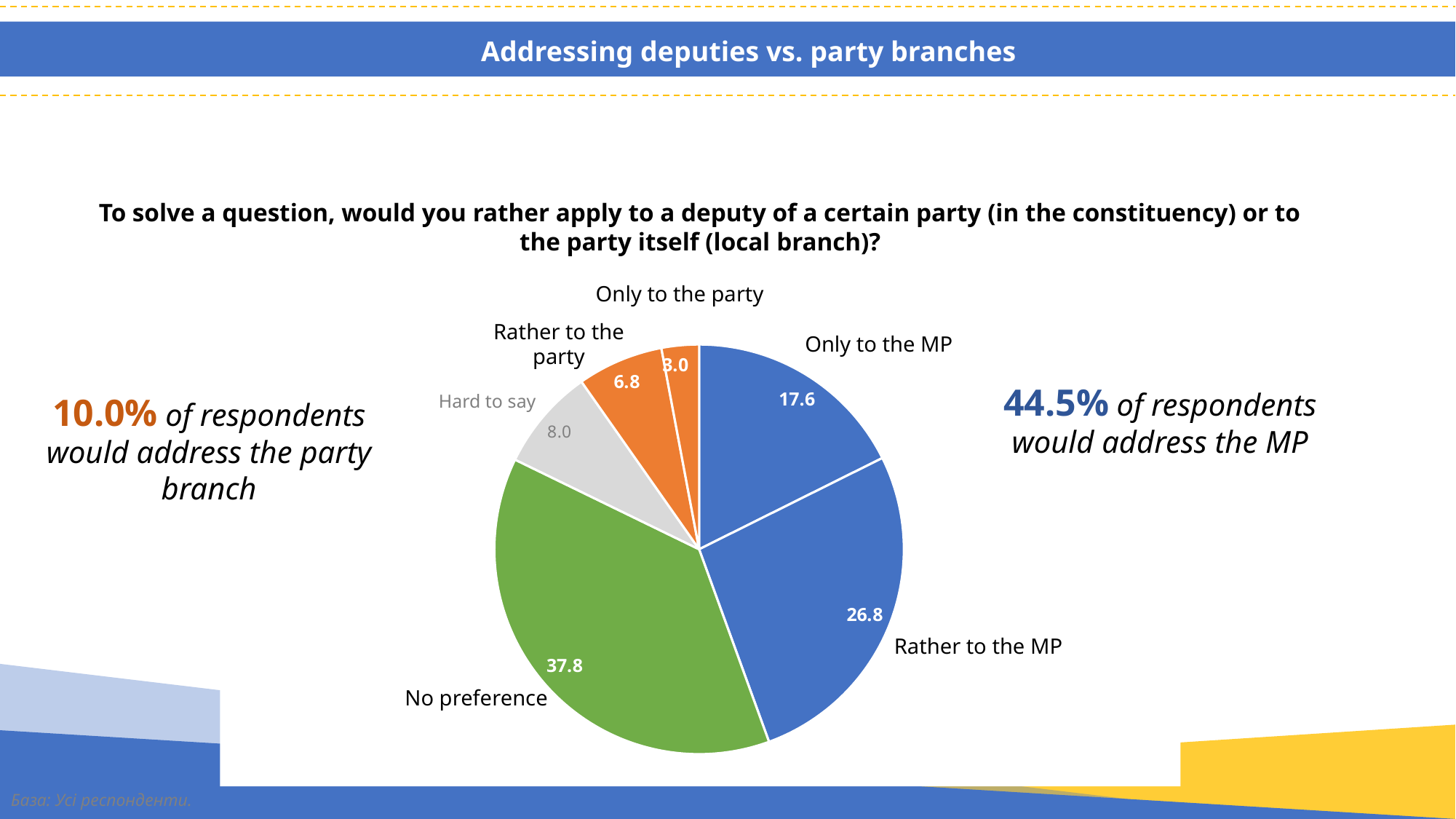
How many slices does the pie chart have? 6 What is the value for "Only to the party"? 3.0 What is the value for "Rather to the MP"? 26.8 Which category has the largest slice of the pie? No preference What colour are the "Only to the party" and "Rather to the party" slices? orange Which is larger, the value for "Rather to the party" or the value for "Hard to say"? Hard to say What type of chart is shown on the slide? pie chart What is the value for "Hard to say"? 8.0 Which category has the smallest slice of the pie? Only to the party What is the value for "No preference"? 37.8 What is the combined value of "Only to the MP" and "Rather to the MP"? 44.4 What is the difference between the values for "Rather to the MP" and "Only to the MP"? 9.2